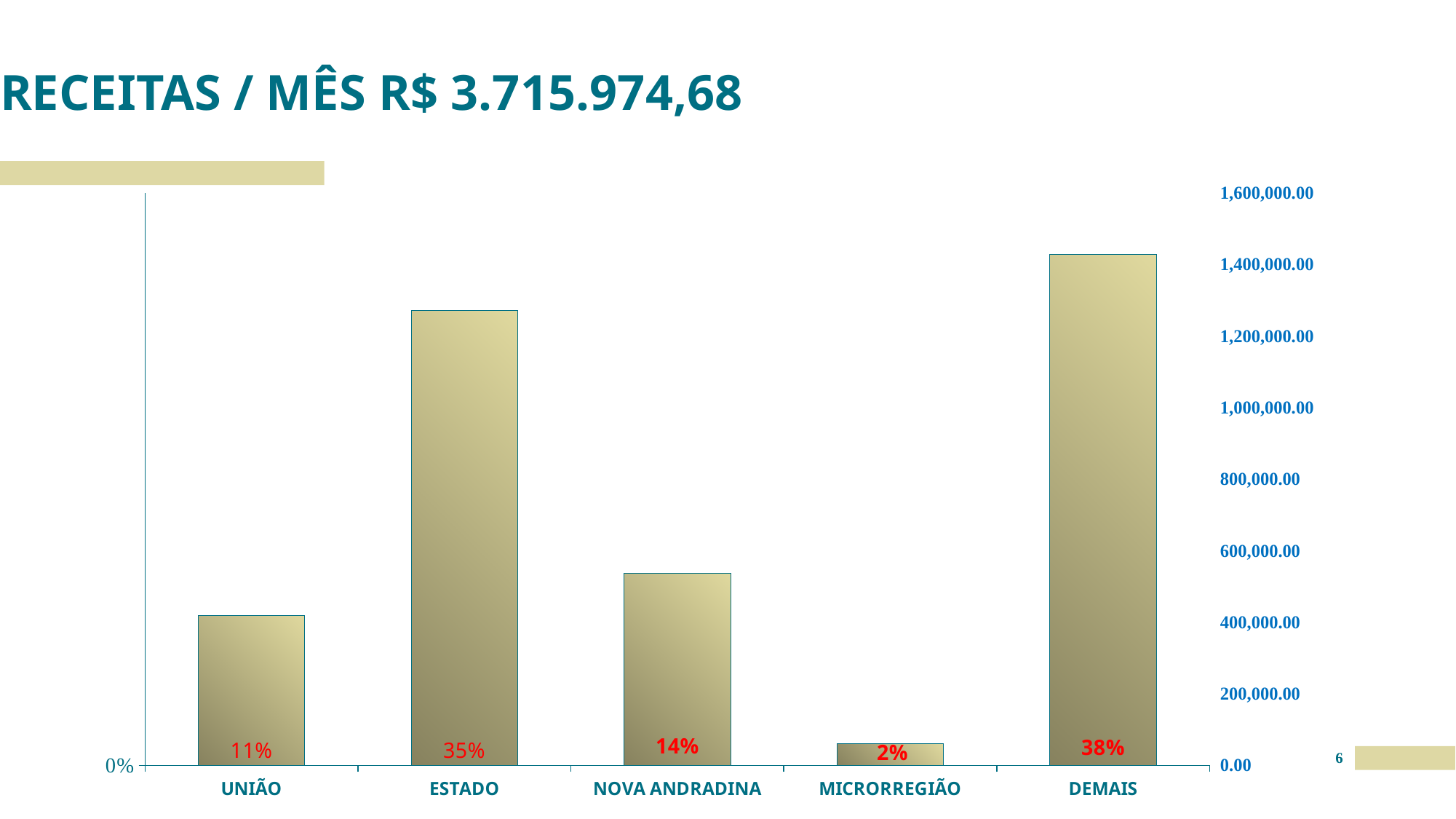
Is the value for ESTADO greater or less than 1,200,000.00? greater What percentage label is shown on the NOVA ANDRADINA bar? 14% What is the title of the slide? RECEITAS / MÊS R$ 3.715.974,68 Which category has the highest bar? DEMAIS Is the value for UNIÃO greater or less than 600,000.00? less What percentage label is shown on the DEMAIS bar? 38% What percentage label is shown on the UNIÃO bar? 11% How many categories are shown on the x axis? 5 What percentage label is shown on the MICRORREGIÃO bar? 2% What percentage label is shown on the ESTADO bar? 35% Which is larger, the bar for ESTADO or the bar for NOVA ANDRADINA? ESTADO Which category has the lowest bar? MICRORREGIÃO